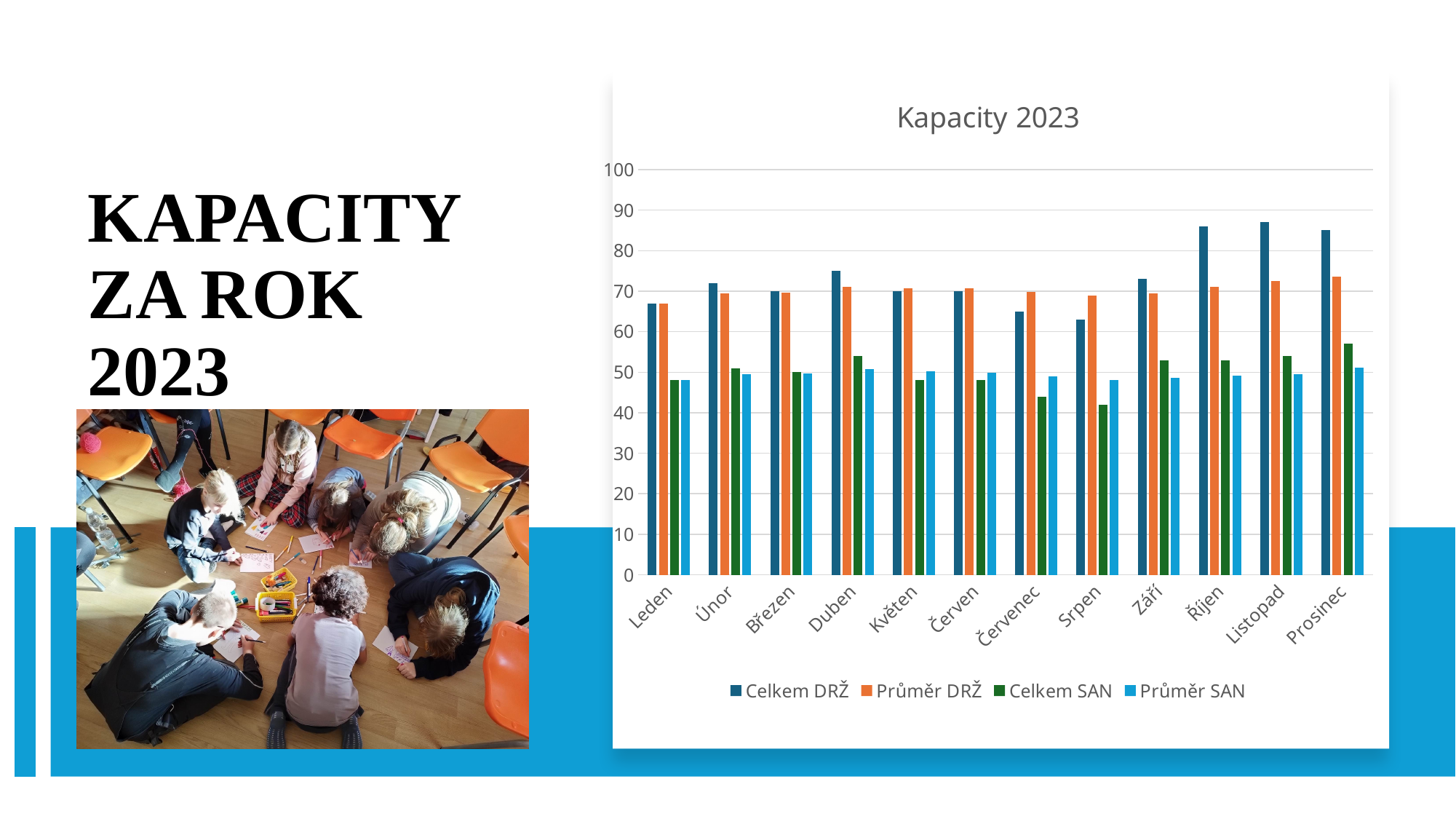
What is the title of the chart? Kapacity 2023 In which month is Celkem SAN highest? Prosinec In which month is Celkem DRŽ lowest? Srpen Is the value of Celkem DRŽ for Říjen greater or less than 80? greater Which series is shown in orange in the legend? Průměr DRŽ Is the value of Celkem DRŽ for Duben greater or less than 70? greater Which is larger, Celkem DRŽ for Listopad or Celkem DRŽ for Leden? Listopad How many months (categories) are shown on the x axis? 12 Is the value of Celkem SAN for Srpen greater or less than 50? less How many series does the chart legend list? 4 What kind of chart is shown on the slide? bar chart